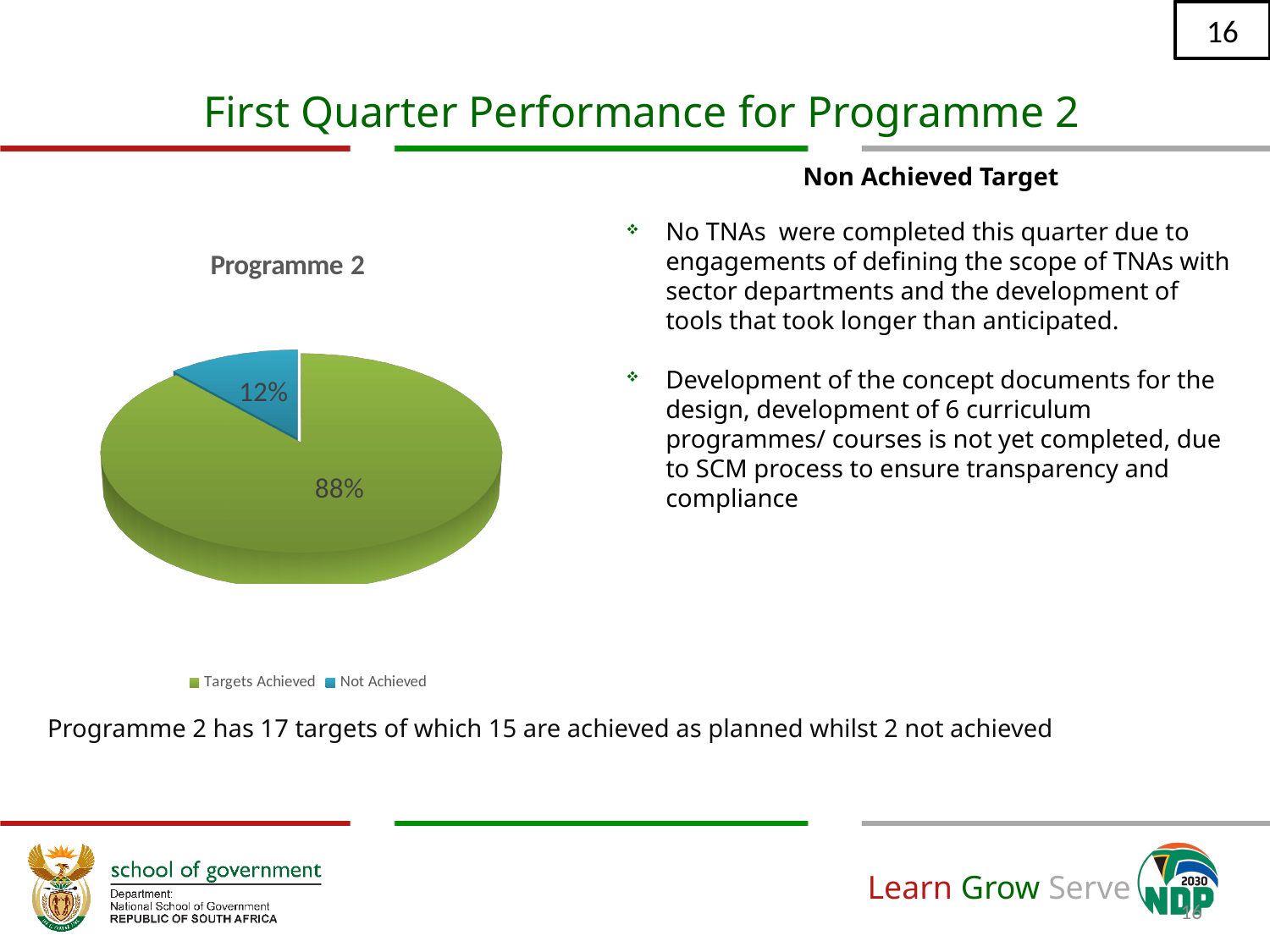
How many entries does the legend list? 2 What is the chart's title? Programme 2 What colour is the Not Achieved slice? blue Which slice is the smallest? Not Achieved What percentage of the pie is labelled Targets Achieved? 88% What share of the pie does the Targets Achieved slice take? 88% Which slice is the largest? Targets Achieved Which is larger, the Targets Achieved slice or the Not Achieved slice? Targets Achieved How many slices does the pie chart have? 2 What percentage of the pie is labelled Not Achieved? 12% What is the difference in percentage points between the Targets Achieved slice and the Not Achieved slice? 76 What kind of chart is shown on the slide? pie chart